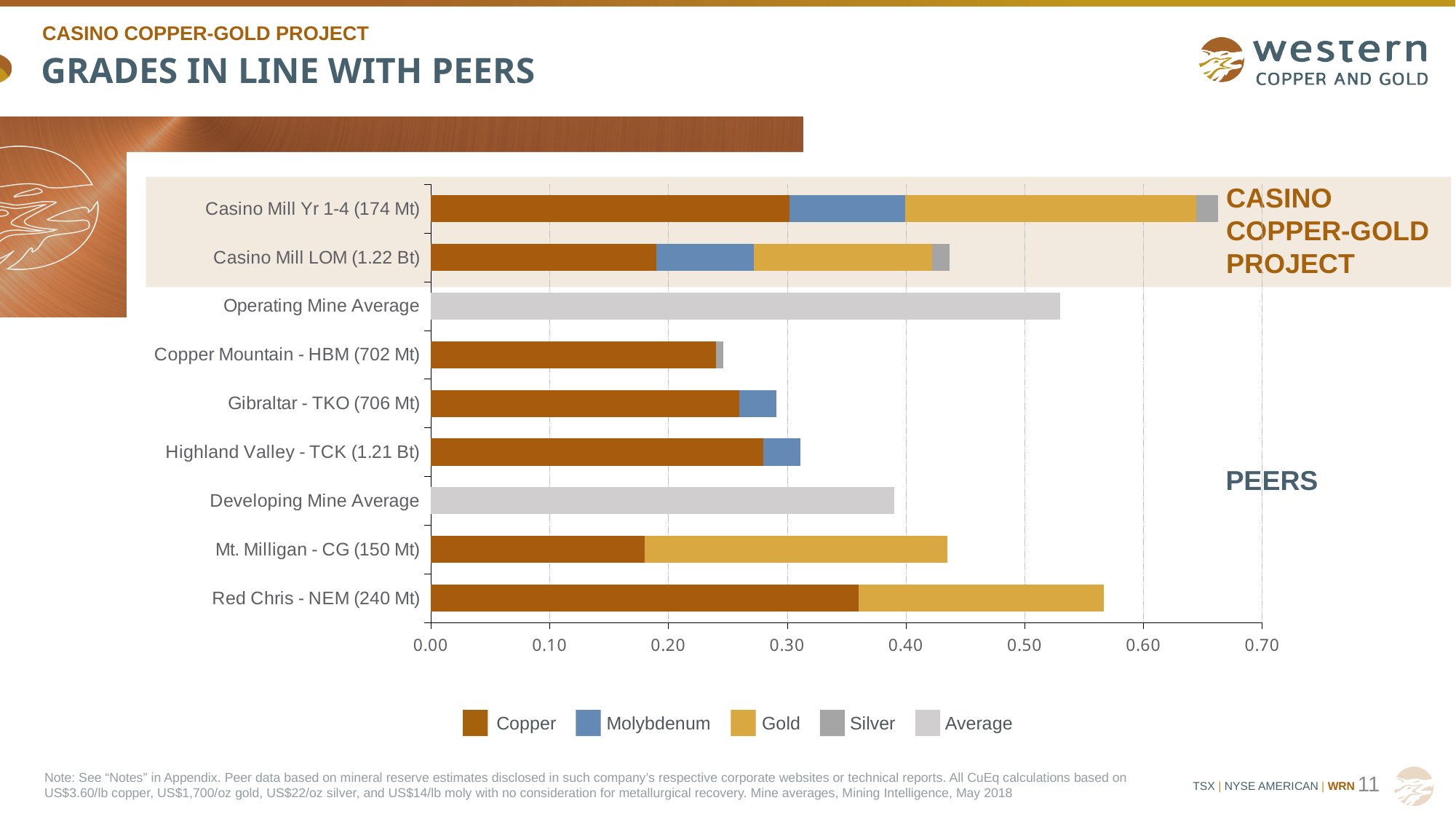
Is the value for Operating Mine Average greater or less than 0.50? greater Which series in the legend is shown in the gold/yellow colour? Gold How many categories (mines/averages) are plotted on the chart? 9 Is the total value for Red Chris - NEM (240 Mt) greater or less than 0.50? greater Is the total value for Copper Mountain - HBM (702 Mt) greater or less than 0.30? less How many series does the chart legend list? 5 Which category has the shortest total bar? Copper Mountain - HBM (702 Mt) Which has the larger total bar, Casino Mill Yr 1-4 (174 Mt) or Casino Mill LOM (1.22 Bt)? Casino Mill Yr 1-4 (174 Mt) What kind of chart is shown on the slide? Bar chart Which has the larger total bar, Red Chris - NEM (240 Mt) or Mt. Milligan - CG (150 Mt)? Red Chris - NEM (240 Mt) Which category has the longest total bar? Casino Mill Yr 1-4 (174 Mt)